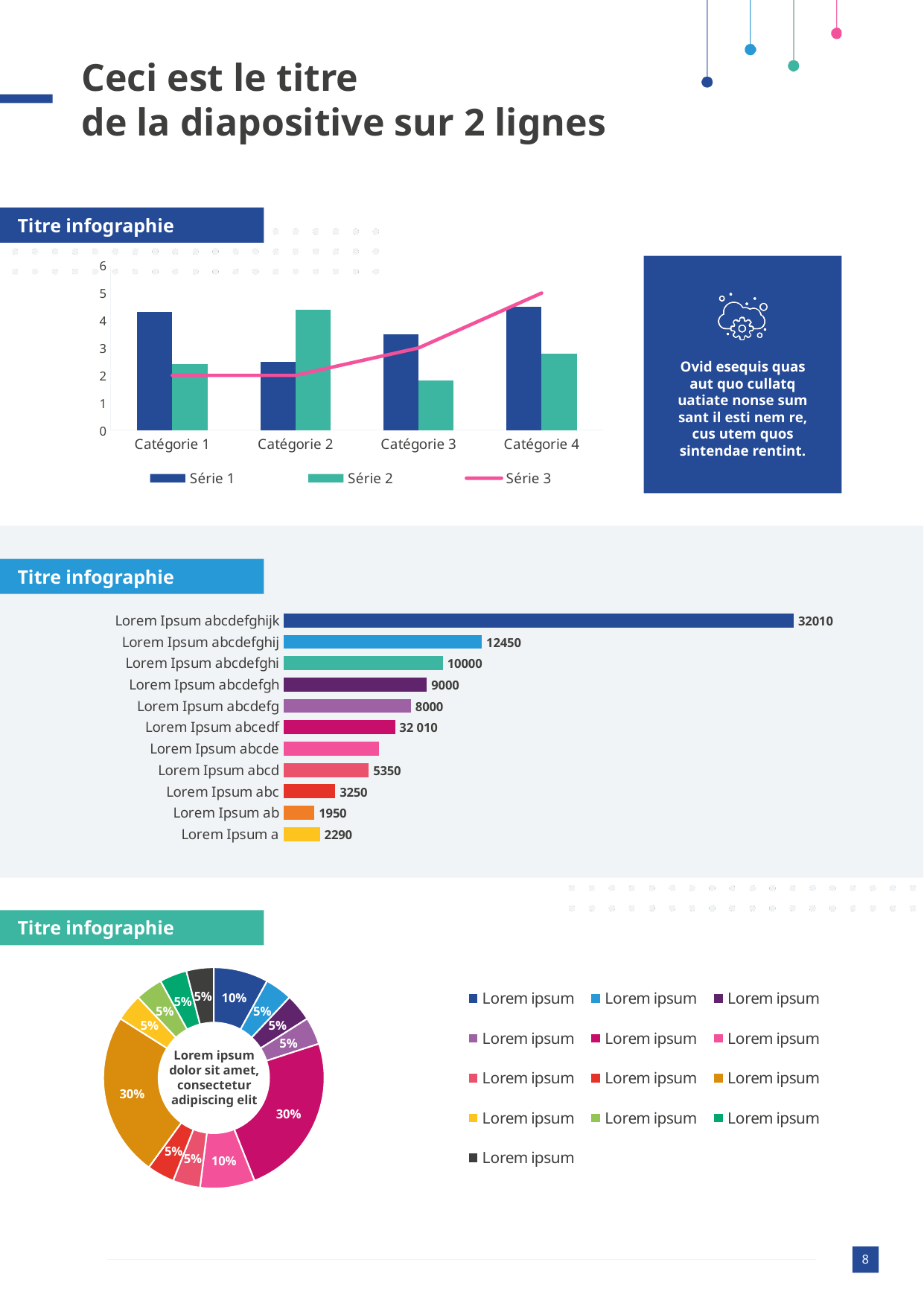
In the bottom chart, what share does the largest slice represent? 30% In the middle chart, what is the value for Lorem Ipsum abc? 3250 How many bars does the middle chart have? 11 In the top chart, which is larger for Catégorie 2: Série 1 or Série 2? Série 2 What kind of chart is the top chart on the slide? bar chart with a line How many series does the legend of the top chart list? 3 How many categories does the top chart show? 4 In the top chart, does the Série 3 line rise or fall from Catégorie 1 to Catégorie 4? rise In the top chart, is the Série 2 value for Catégorie 3 greater or less than 2? less In the middle chart, what is the value for Lorem Ipsum abcdefghijk? 32010 How many slices does the bottom donut chart have? 13 In the middle chart, what is the difference between Lorem Ipsum abcdefghij and Lorem Ipsum abcdefghi? 2450